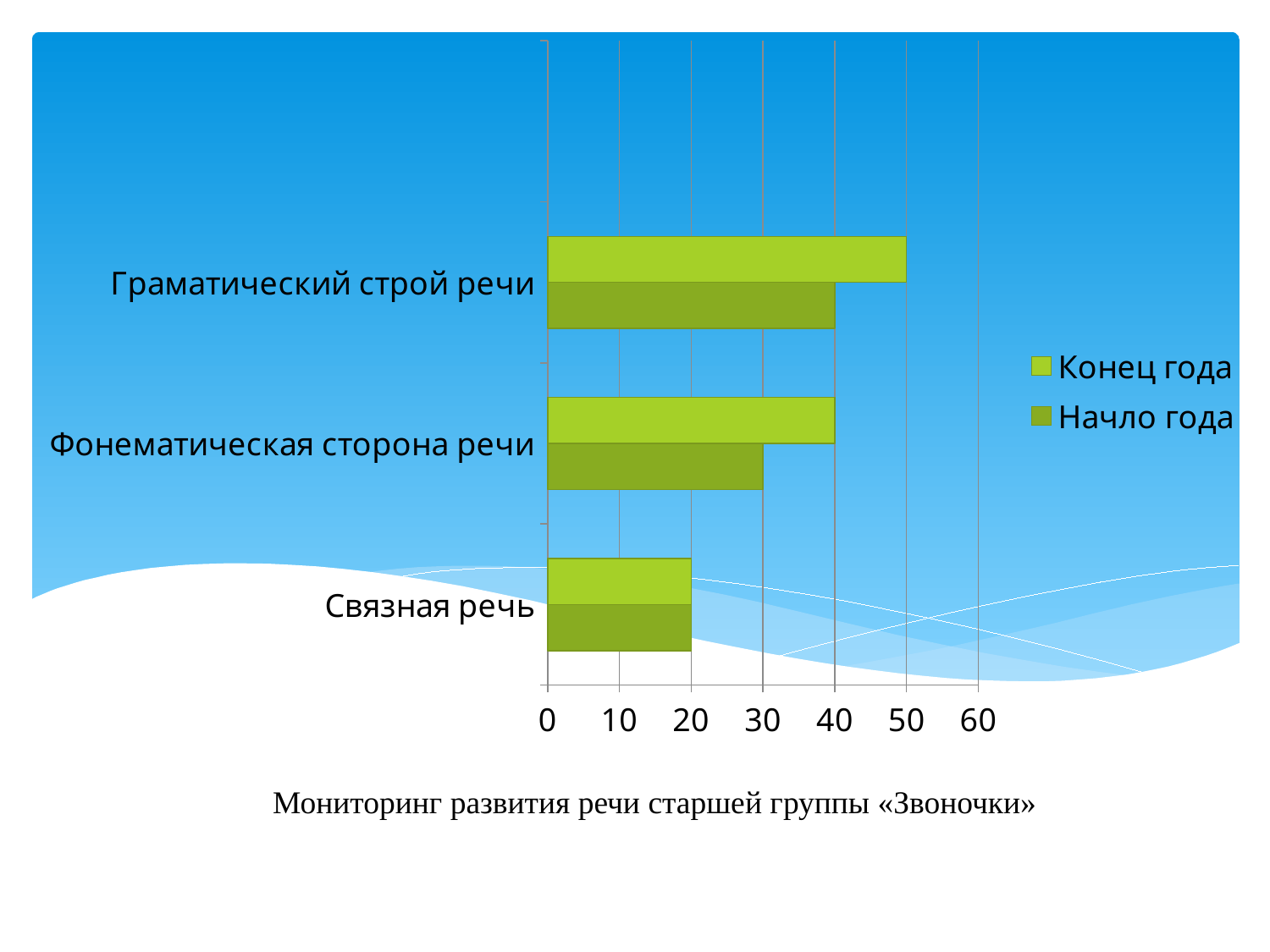
What is the value for Связная речь in the Конец года series? 20 What is the difference between the Конец года and Начло года values for Фонематическая сторона речи? 10 What is the value for Граматический строй речи in the Конец года series? 50 Which category has the highest value in the Конец года series? Граматический строй речи Which category has the lowest value in the Начло года series? Связная речь How many categories are plotted on the chart? 3 For Граматический строй речи, which series has the larger value, Конец года or Начло года? Конец года What are the two legend entries of the chart? Конец года, Начло года What is the value for Фонематическая сторона речи in the Начло года series? 30 What is the value for Граматический строй речи in the Начло года series? 40 How many series does the legend list? 2 What kind of chart is shown on the slide? bar chart